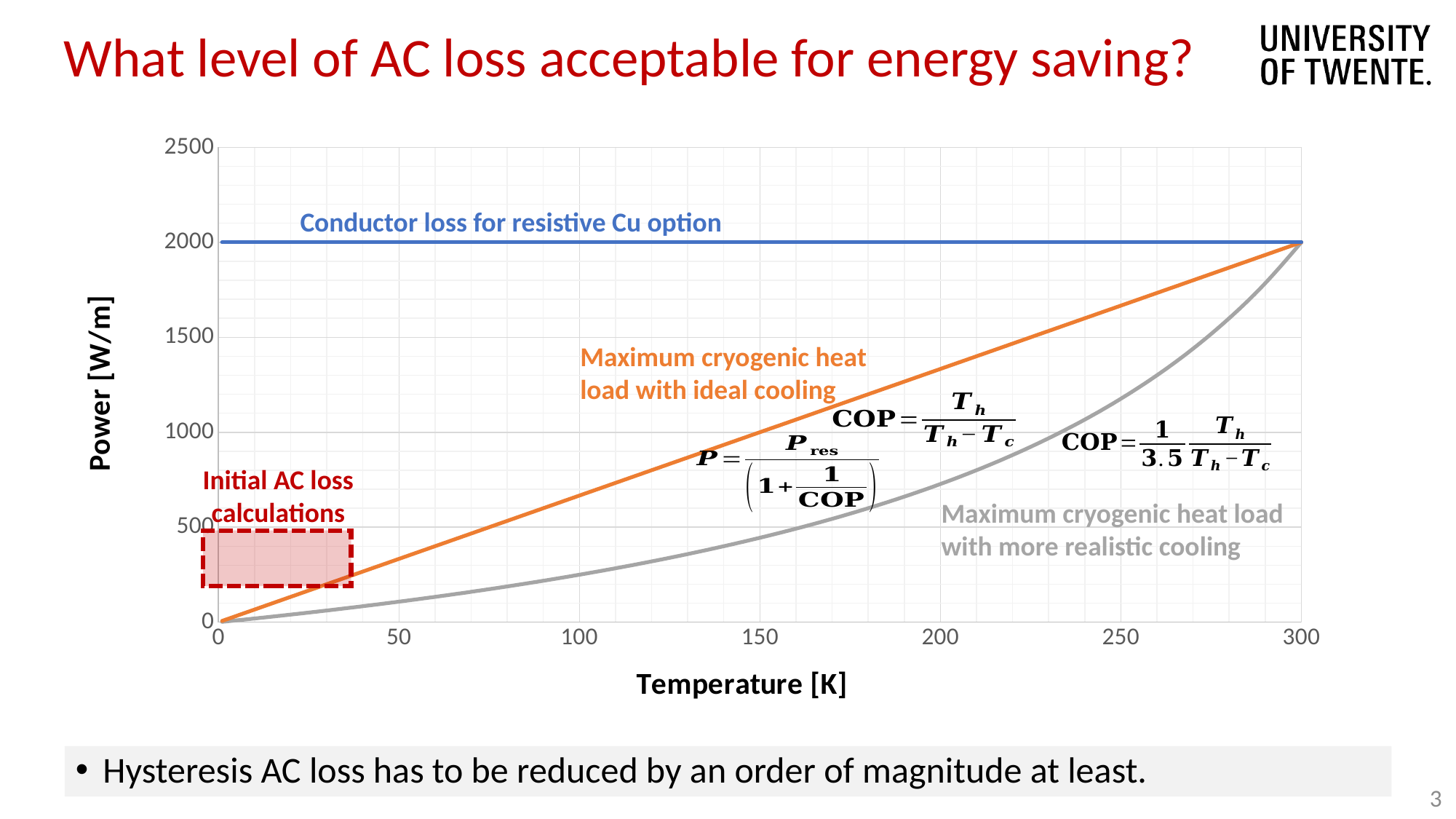
Is the 'Conductor loss for resistive Cu option' line greater or less than 1500? greater What is the label of the x axis? Temperature [K] Does the 'Maximum cryogenic heat load with ideal cooling' line rise or fall as temperature increases? rise What kind of chart is shown on the slide? line chart What value do the 'Maximum cryogenic heat load with ideal cooling' and 'with more realistic cooling' curves reach at 300 K? 2000 What is the label of the y axis? Power [W/m] Which of the three lines has the lowest value at 100 K? Maximum cryogenic heat load with more realistic cooling At 150 K, which is larger: the 'Maximum cryogenic heat load with ideal cooling' or the 'Maximum cryogenic heat load with more realistic cooling'? Maximum cryogenic heat load with ideal cooling Is the value of the 'Maximum cryogenic heat load with ideal cooling' line at 100 K greater or less than 1000? less Is the value of the 'Maximum cryogenic heat load with more realistic cooling' curve at 200 K greater or less than 1000? less How many lines (series) are plotted on the chart? 3 What is the value of the 'Conductor loss for resistive Cu option' line in W/m? 2000